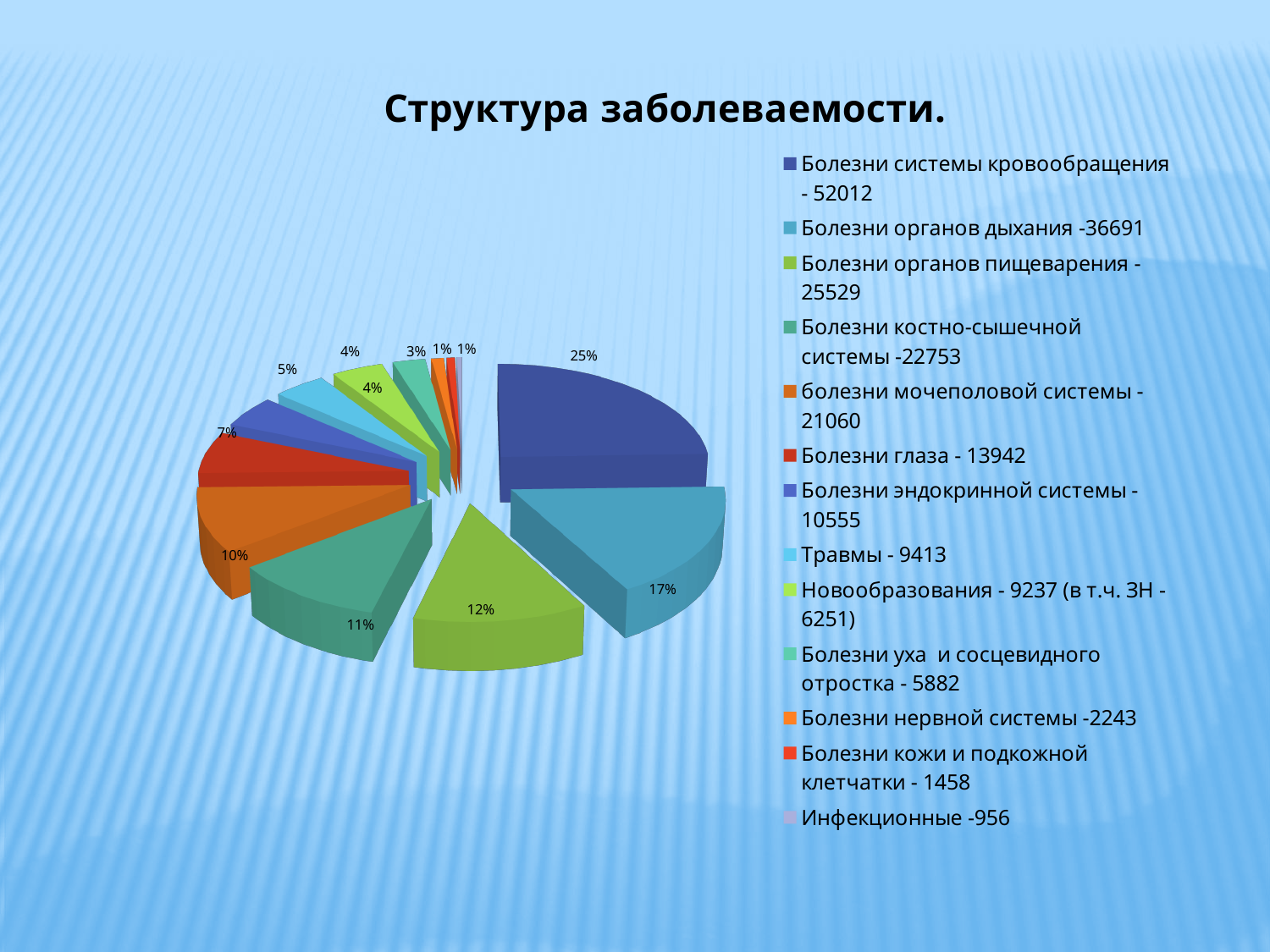
What share of the pie does Болезни органов пищеварения take? 12% What value is given in the legend for Травмы? 9413 What share of the pie does Болезни глаза take? 7% What is the difference in percentage points between the shares of Болезни системы кровообращения and Болезни органов дыхания? 8 Which category in the legend has the smallest value? Инфекционные What kind of chart is shown on the slide? pie chart What share of the pie does Болезни органов дыхания take? 17% Which is larger, the slice for Болезни костно-сышечной системы or the slice for болезни мочеполовой системы? Болезни костно-сышечной системы How many categories does the legend list? 13 What is the title of the chart? Структура заболеваемости. Which category has the largest slice of the pie? Болезни системы кровообращения